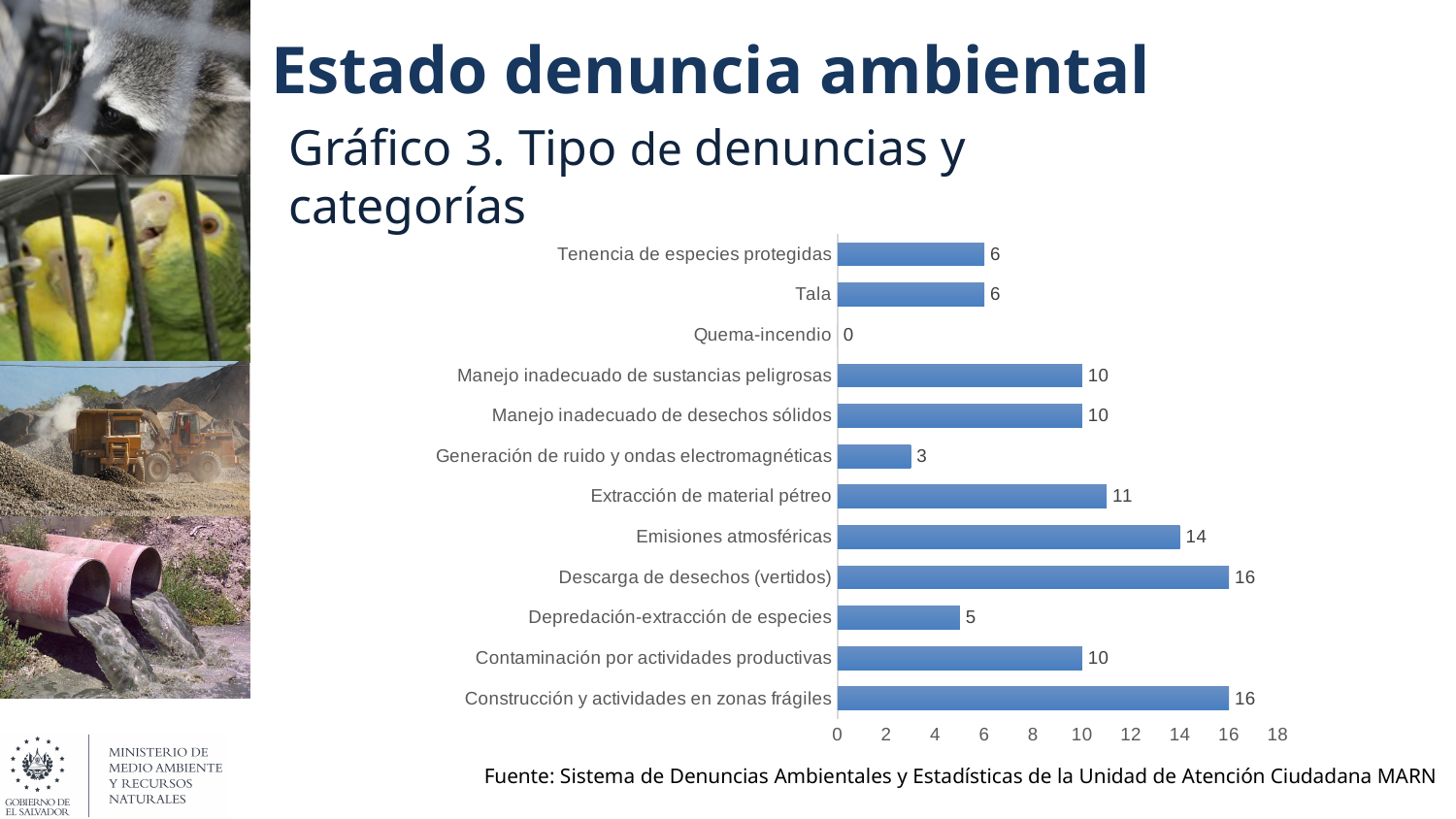
What is the value for Emisiones atmosféricas? 14 What is the difference between Manejo inadecuado de desechos sólidos and Tala? 4 What kind of chart is shown on the slide? Bar chart Which category has the lowest value? Quema-incendio How many categories are shown in the chart? 12 What is the difference between Descarga de desechos (vertidos) and Emisiones atmosféricas? 2 What is the title of the chart? Gráfico 3. Tipo de denuncias y categorías What is the value for Depredación-extracción de especies? 5 Which is larger, Depredación-extracción de especies or Tenencia de especies protegidas? Tenencia de especies protegidas What is the value for Extracción de material pétreo? 11 What is the value for Generación de ruido y ondas electromagnéticas? 3 Which is larger, Extracción de material pétreo or Contaminación por actividades productivas? Extracción de material pétreo